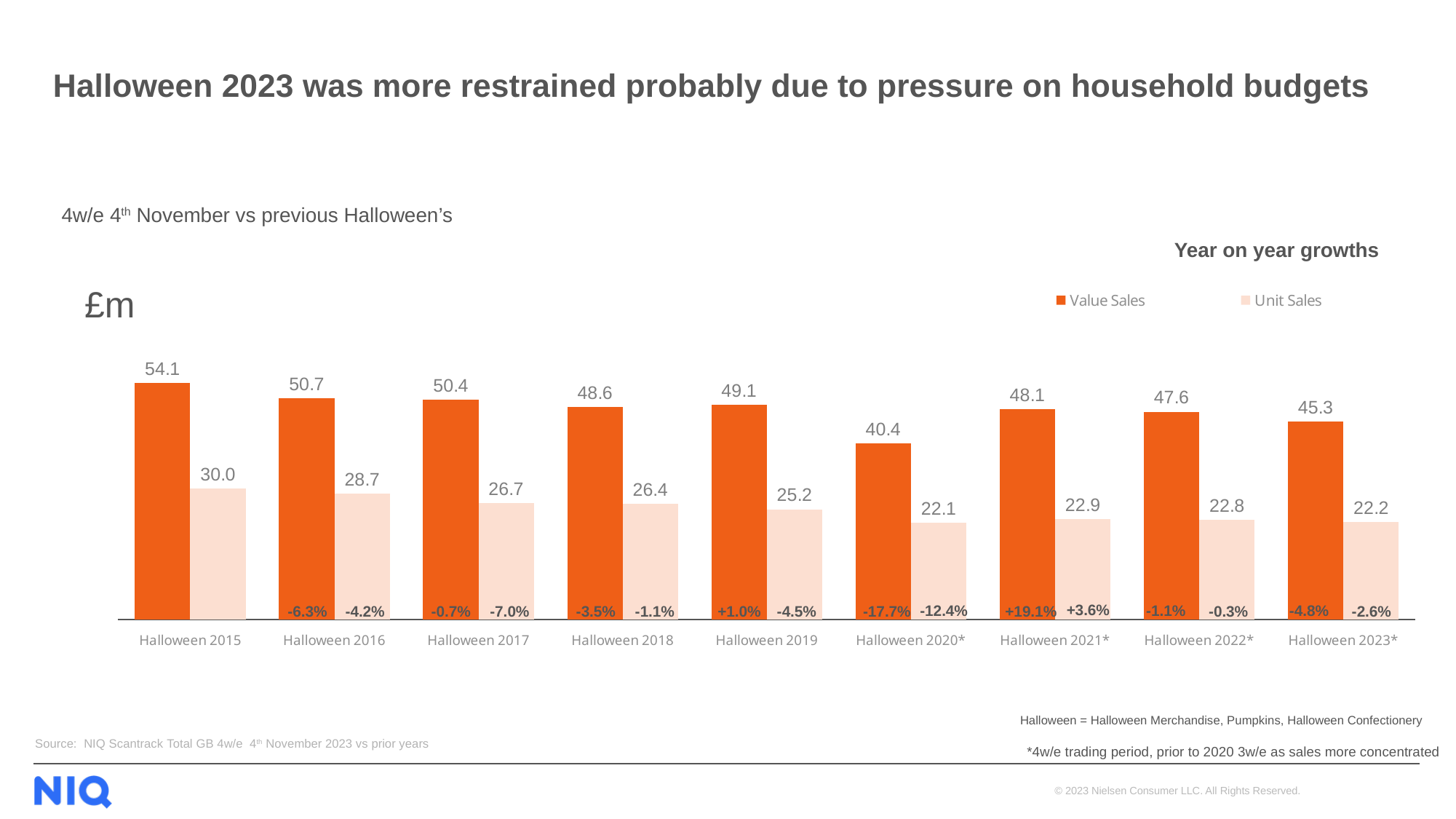
What is the Unit Sales figure for Halloween 2015? 30.0 What is the Value Sales figure for Halloween 2023*? 45.3 What kind of chart is shown on the slide? Bar chart Which Halloween has the highest Value Sales? Halloween 2015 What unit is shown for the chart's values? £m Which is larger, Unit Sales for Halloween 2021* or Unit Sales for Halloween 2020*? Halloween 2021* What is the year on year growth in Unit Sales shown for Halloween 2023*? -2.6% How many Halloween periods are shown on the x axis? 9 Which Halloween has the lowest Value Sales? Halloween 2020* How many series does the legend list? 2 What is the difference between Value Sales for Halloween 2015 and Halloween 2023*? 8.8 What is the year on year growth in Value Sales shown for Halloween 2021*? +19.1%